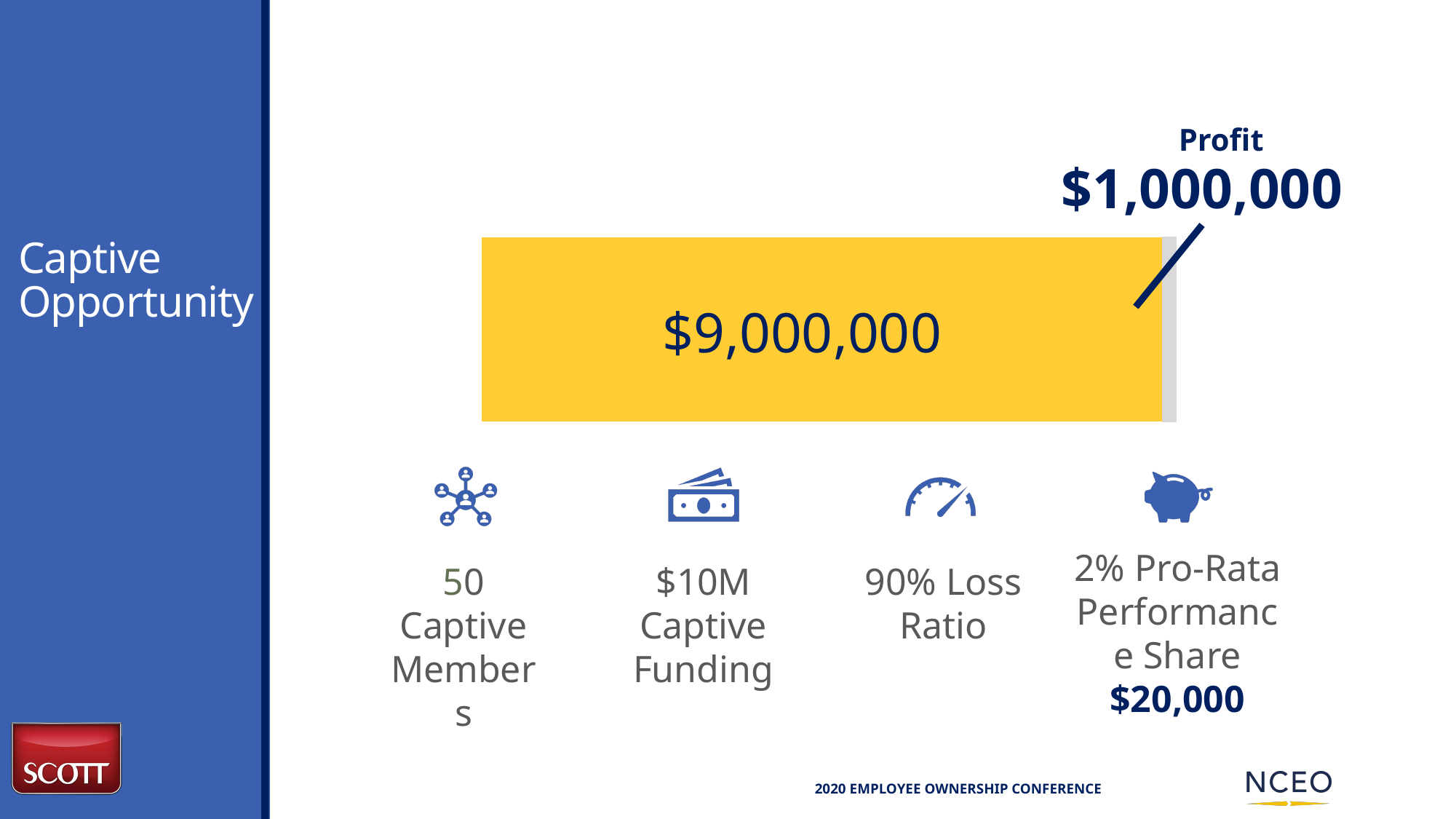
Which segment of the bar is the largest? The $9,000,000 segment How many segments make up the stacked bar? 2 Which segment of the bar is the smallest? The Profit segment ($1,000,000) What colour is the large segment of the bar? Yellow What is the Profit value labelled at the end of the bar? $1,000,000 What kind of chart is shown on the slide? Bar chart What is the total of the two segments of the stacked bar? $10,000,000 What is the difference between the yellow segment value and the Profit value? $8,000,000 Which is larger, the yellow segment of the bar or the Profit segment? The yellow segment ($9,000,000) What value is printed on the large yellow segment of the bar? $9,000,000 What label is attached to the thin grey segment at the right end of the bar? Profit